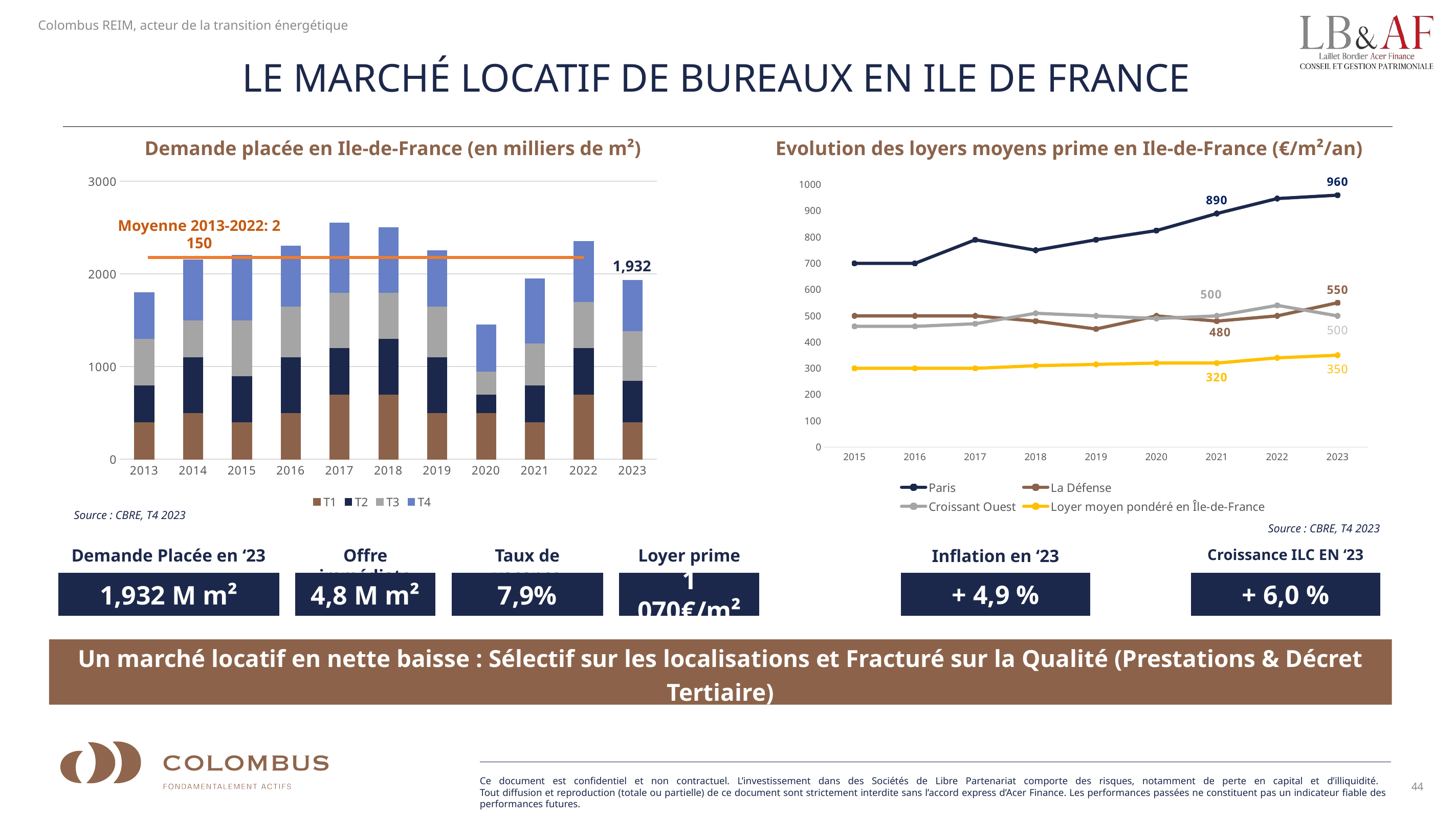
In the right chart 'Evolution des loyers moyens prime en Ile-de-France', which is higher in 2023: La Défense or Croissant Ouest? La Défense In the left chart 'Demande placée en Ile-de-France', how many series does the legend list? 4 What kind of chart is the left chart, 'Demande placée en Ile-de-France'? Stacked bar chart In the right chart 'Evolution des loyers moyens prime en Ile-de-France', does the Paris line rise or fall from 2015 to 2023? Rises In the right chart 'Evolution des loyers moyens prime en Ile-de-France', by how much did the Paris value increase between 2021 and 2023? 70 In the left chart 'Demande placée en Ile-de-France', what is the total value labelled for 2023? 1,932 In the right chart 'Evolution des loyers moyens prime en Ile-de-France', what is the value for Paris in 2023? 960 In the right chart 'Evolution des loyers moyens prime en Ile-de-France', what is the value for La Défense in 2023? 550 In the left chart 'Demande placée en Ile-de-France', which year has the lowest total bar? 2020 In the left chart 'Demande placée en Ile-de-France', how many years are shown on the x axis? 11 What kind of chart is the right chart, 'Evolution des loyers moyens prime en Ile-de-France'? Line chart In the left chart 'Demande placée en Ile-de-France', is the total for 2020 greater or less than 2000? less